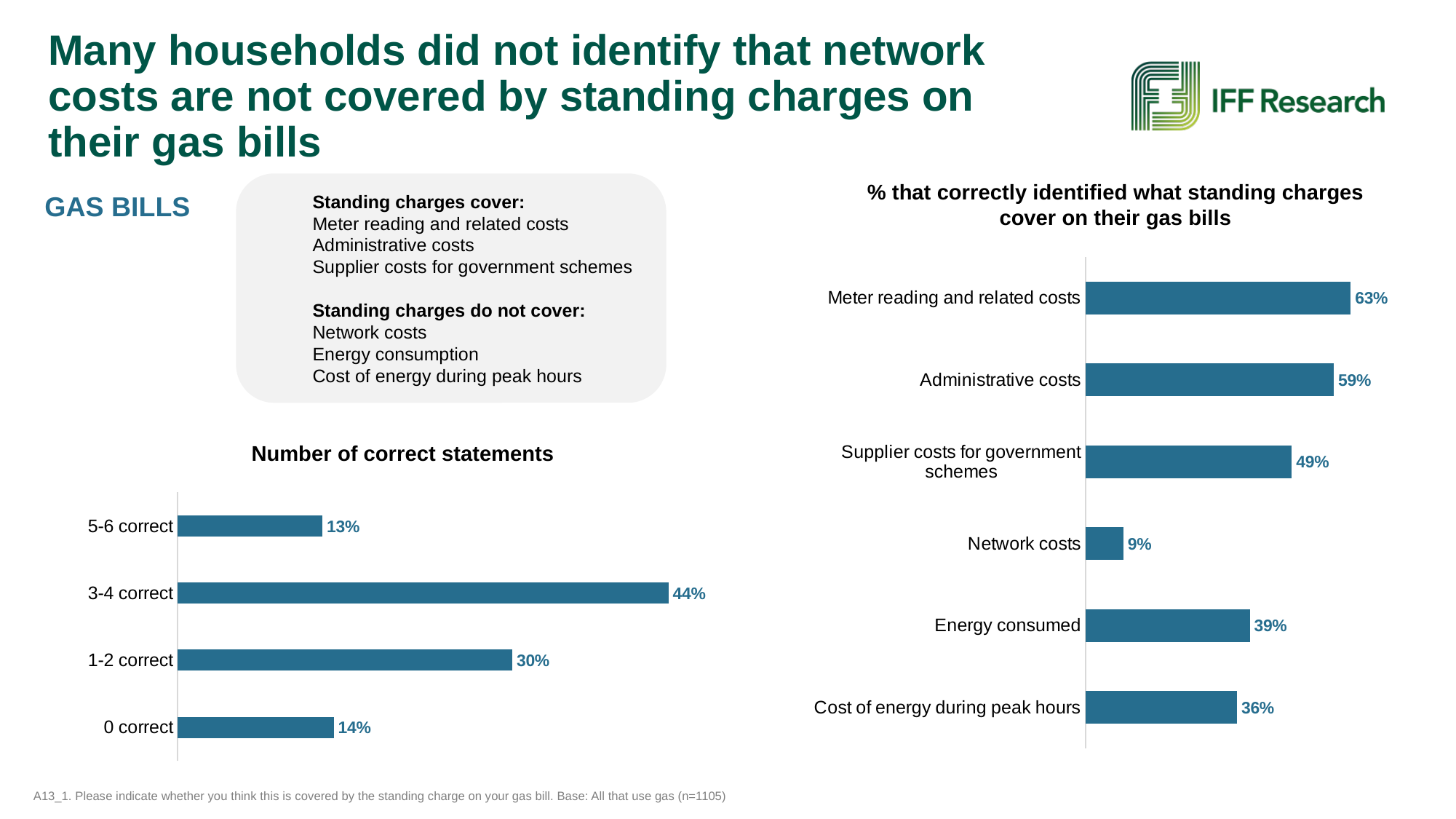
In the '% that correctly identified what standing charges cover on their gas bills' chart, which category has the highest value? Meter reading and related costs In the 'Number of correct statements' chart, what percentage got 3-4 correct? 44% In the '% that correctly identified what standing charges cover on their gas bills' chart, what is the difference between Meter reading and related costs and Administrative costs? 4% In the 'Number of correct statements' chart, how many categories are shown? 4 In the '% that correctly identified what standing charges cover on their gas bills' chart, how many categories are shown? 6 In the 'Number of correct statements' chart, which category has the lowest value? 5-6 correct In the '% that correctly identified what standing charges cover on their gas bills' chart, what is the value for Supplier costs for government schemes? 49% What type of chart is the 'Number of correct statements' chart? Bar chart In the '% that correctly identified what standing charges cover on their gas bills' chart, what is the value for Network costs? 9% In the '% that correctly identified what standing charges cover on their gas bills' chart, which is larger: Energy consumed or Cost of energy during peak hours? Energy consumed In the 'Number of correct statements' chart, what is the difference between the 3-4 correct and 1-2 correct values? 14% In the 'Number of correct statements' chart, what percentage got 0 correct? 14%